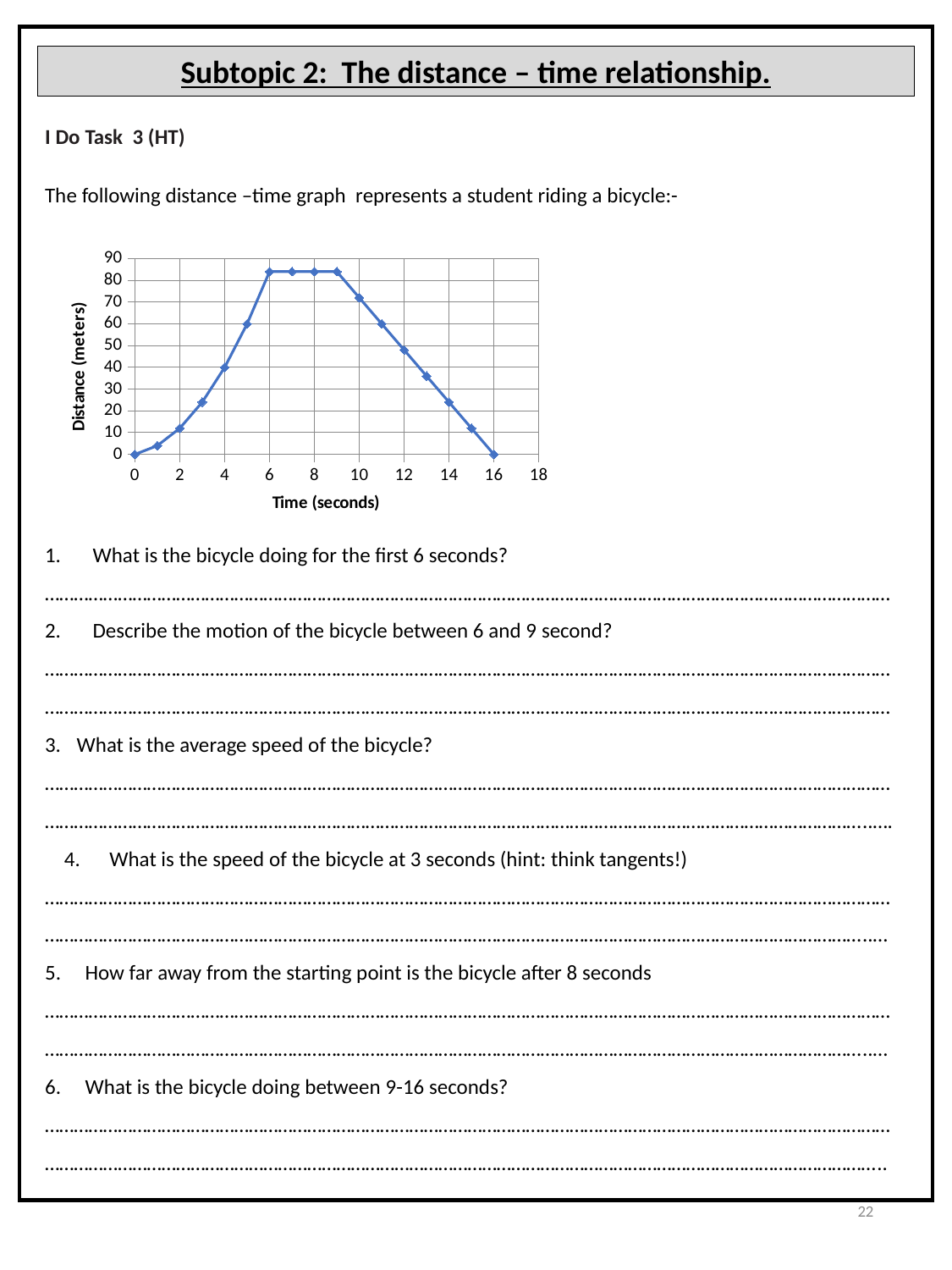
What kind of chart is shown on the slide? line chart Which is larger, the distance at 5 seconds or the distance at 14 seconds? 5 seconds Is the distance at 2 seconds greater or less than 20? less Does the distance rise or fall between 10 and 16 seconds? fall What is the distance at 16 seconds? 0 What is the title of the vertical axis of the chart? Distance (meters) What is the title of the horizontal axis of the chart? Time (seconds) What is the distance at 4 seconds? 40 Is the distance at 13 seconds greater or less than 30? greater What is the distance at 0 seconds? 0 How many data points are plotted on the line? 17 Is the distance at 8 seconds greater or less than 80? greater